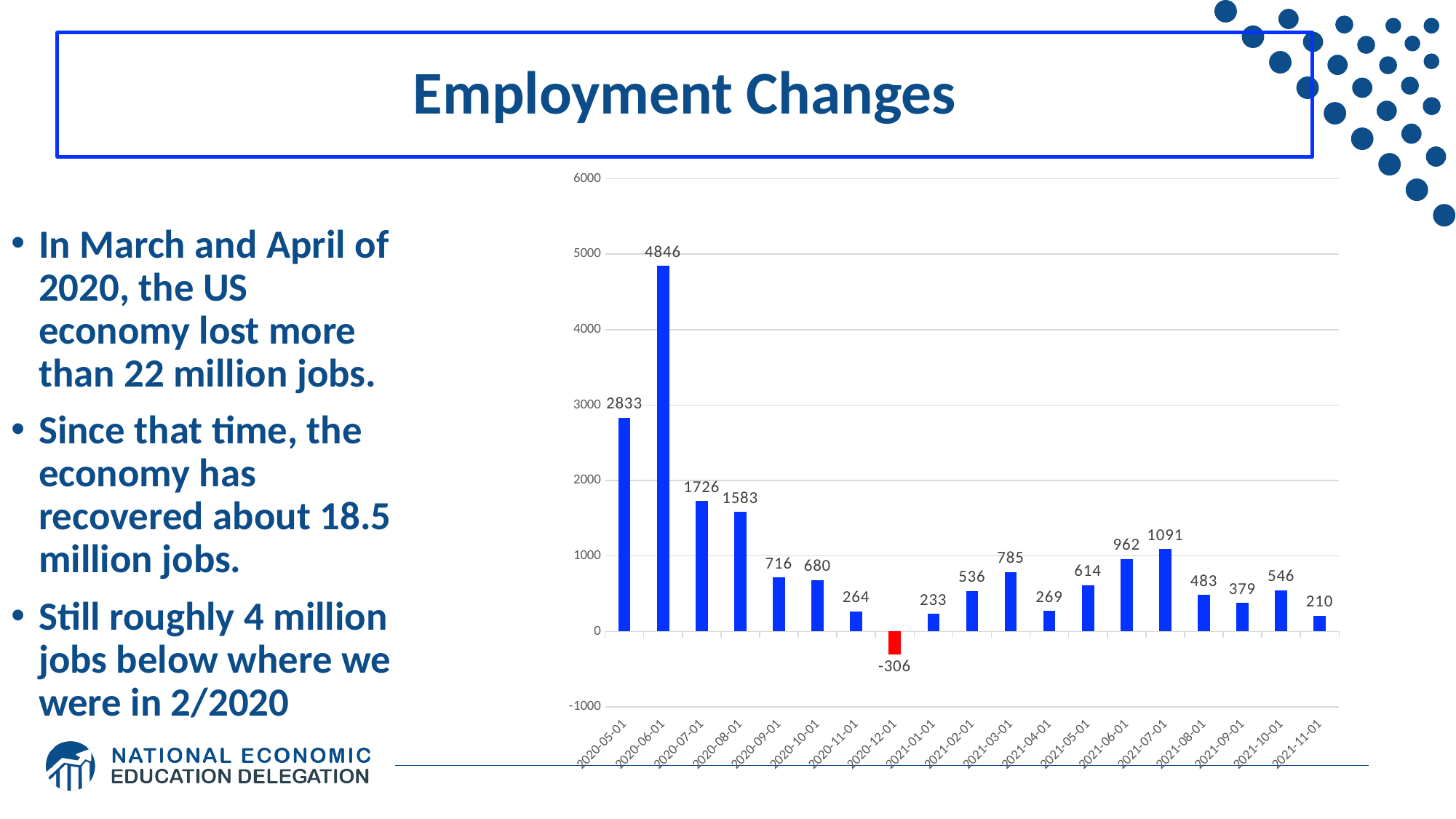
What is the value for 2021-07-01? 1091 Which date has the lowest value? 2020-12-01 What is the value for 2020-12-01? -306 What is the difference between the values for 2021-07-01 and 2021-06-01? 129 What kind of chart is shown on the slide? bar chart Which date has the highest value? 2020-06-01 What is the value for 2020-06-01? 4846 Which is larger, the value for 2020-09-01 or the value for 2020-10-01? 2020-09-01 How many dates are shown on the x axis? 19 Is the value for 2020-07-01 greater or less than 2000? less What is the difference between the values for 2020-06-01 and 2020-05-01? 2013 Which bar is coloured red instead of blue? 2020-12-01